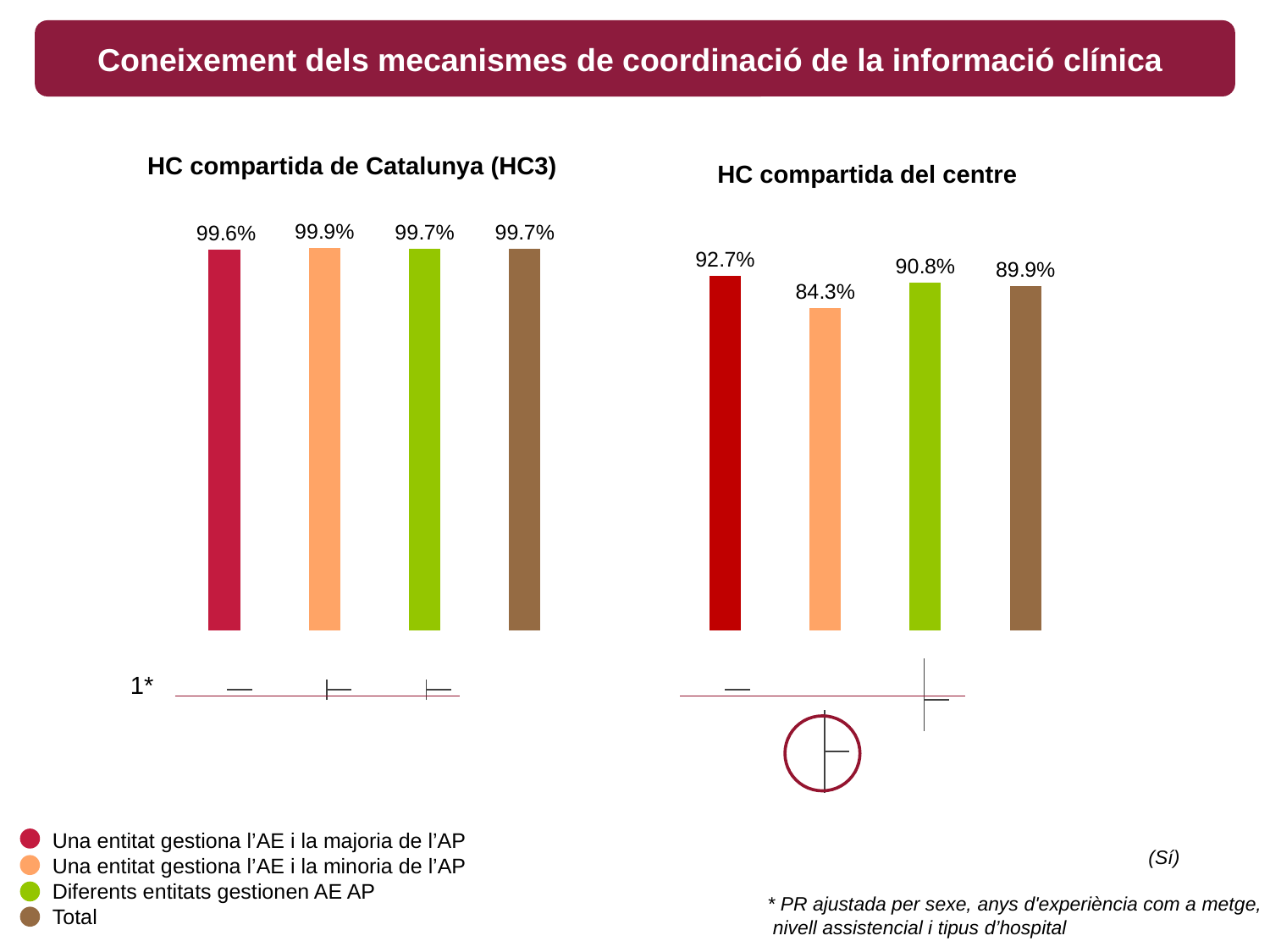
In the 'HC compartida del centre' chart, what is the value for 'Una entitat gestiona l'AE i la majoria de l'AP'? 92.7% In the 'HC compartida de Catalunya (HC3)' chart, what is the value for 'Diferents entitats gestionen AE AP'? 99.7% In the 'HC compartida del centre' chart, which is larger: the value for 'Diferents entitats gestionen AE AP' or the value for 'Total'? Diferents entitats gestionen AE AP How many entries does the legend at the bottom of the slide list? 4 In the 'HC compartida del centre' chart, what is the value for 'Una entitat gestiona l'AE i la minoria de l'AP'? 84.3% In the 'HC compartida del centre' chart, which category has the lowest value? Una entitat gestiona l'AE i la minoria de l'AP In the 'HC compartida del centre' chart, which category has the highest value? Una entitat gestiona l'AE i la majoria de l'AP What type of chart is 'HC compartida del centre'? Bar chart How many bars are shown in the 'HC compartida de Catalunya (HC3)' chart? 4 In the 'HC compartida de Catalunya (HC3)' chart, what is the value for 'Total'? 99.7% In the 'HC compartida de Catalunya (HC3)' chart, which category has the lowest value? Una entitat gestiona l'AE i la majoria de l'AP In the 'HC compartida del centre' chart, what is the difference between the values for 'Una entitat gestiona l'AE i la majoria de l'AP' and 'Una entitat gestiona l'AE i la minoria de l'AP'? 8.4%